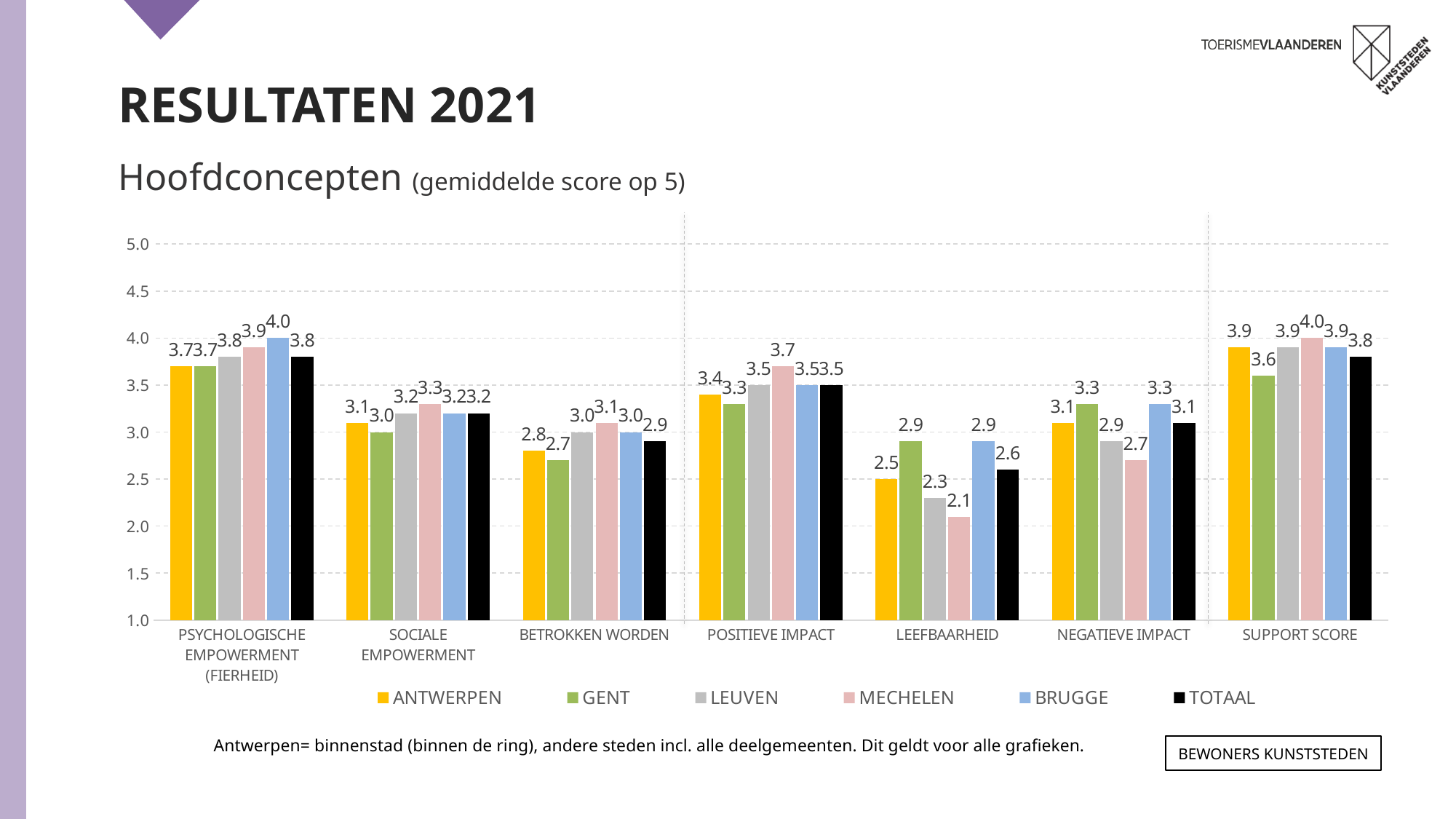
What is the value for Mechelen in the Leefbaarheid category? 2.1 Which series is shown in black in the legend? TOTAAL How many categories are shown on the x axis? 7 Which city has the highest value for Positieve Impact? Mechelen What is the difference between the Gent and Mechelen values for Negatieve Impact? 0.6 What is the Totaal value for Support Score? 3.8 What kind of chart is shown on the slide? Bar chart Which city has the lowest value for Leefbaarheid? Mechelen How many series does the legend list? 6 What is the value for Brugge in the Psychologische Empowerment (Fierheid) category? 4.0 What is the value for Antwerpen in the Betrokken Worden category? 2.8 Which is larger for Sociale Empowerment: the value for Antwerpen or the value for Mechelen? Mechelen